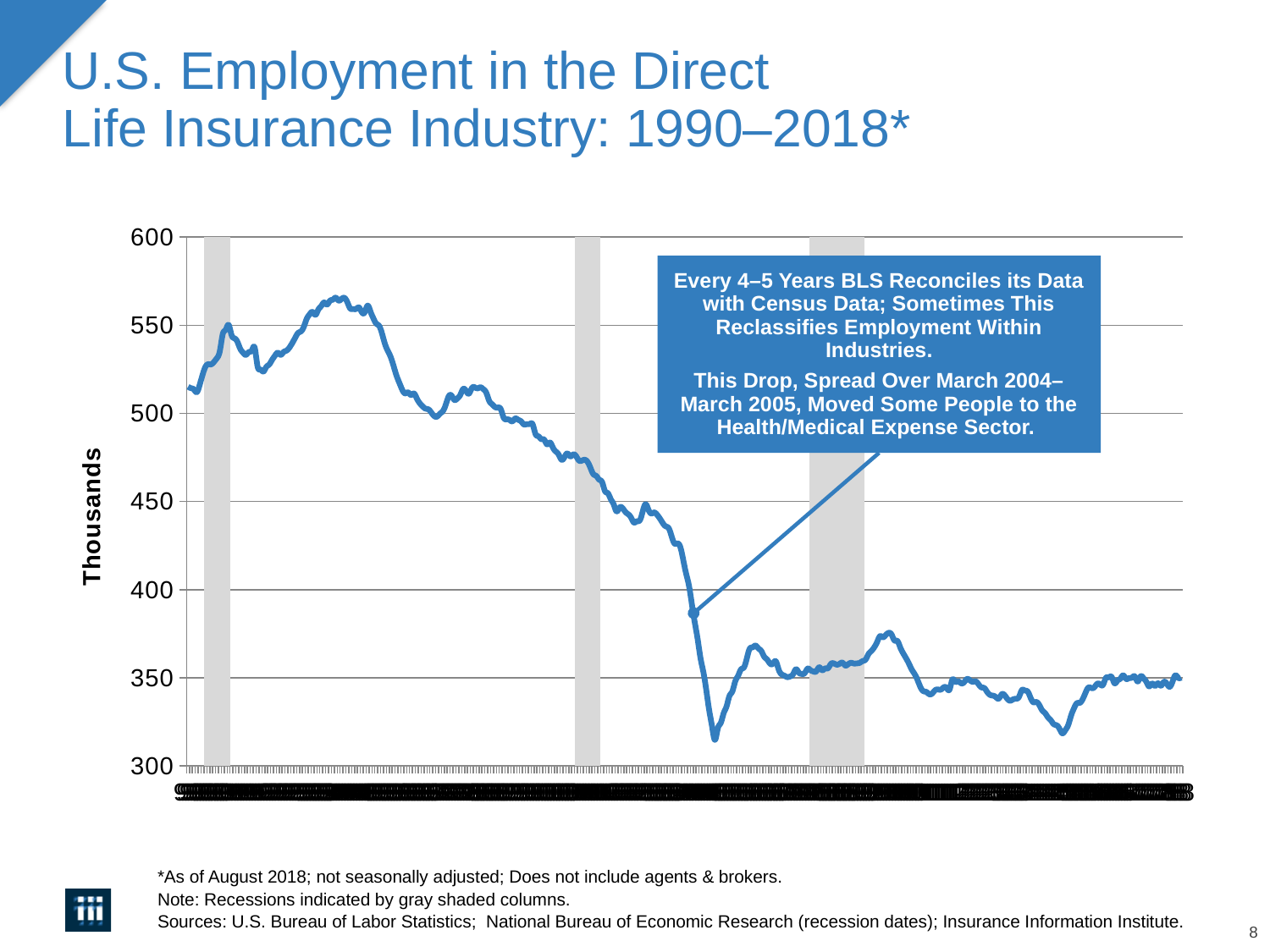
Overall, does U.S. employment in the direct life insurance industry rise or fall from 1990 to 2018 along the x axis? fall Is the lowest point of the line greater or less than 350? less Is the highest point of the line greater or less than 550? greater What is the unit shown on the vertical axis label? Thousands Is the value at the start of the series (1990) greater or less than 500? greater How many gray shaded recession columns are shown on the chart? 3 Is the value at the end of the series (August 2018) greater or less than the value at the start of the series (1990)? less What is the highest value shown on the vertical axis? 600 What is the lowest value shown on the vertical axis? 300 What kind of chart is shown on the slide? line chart